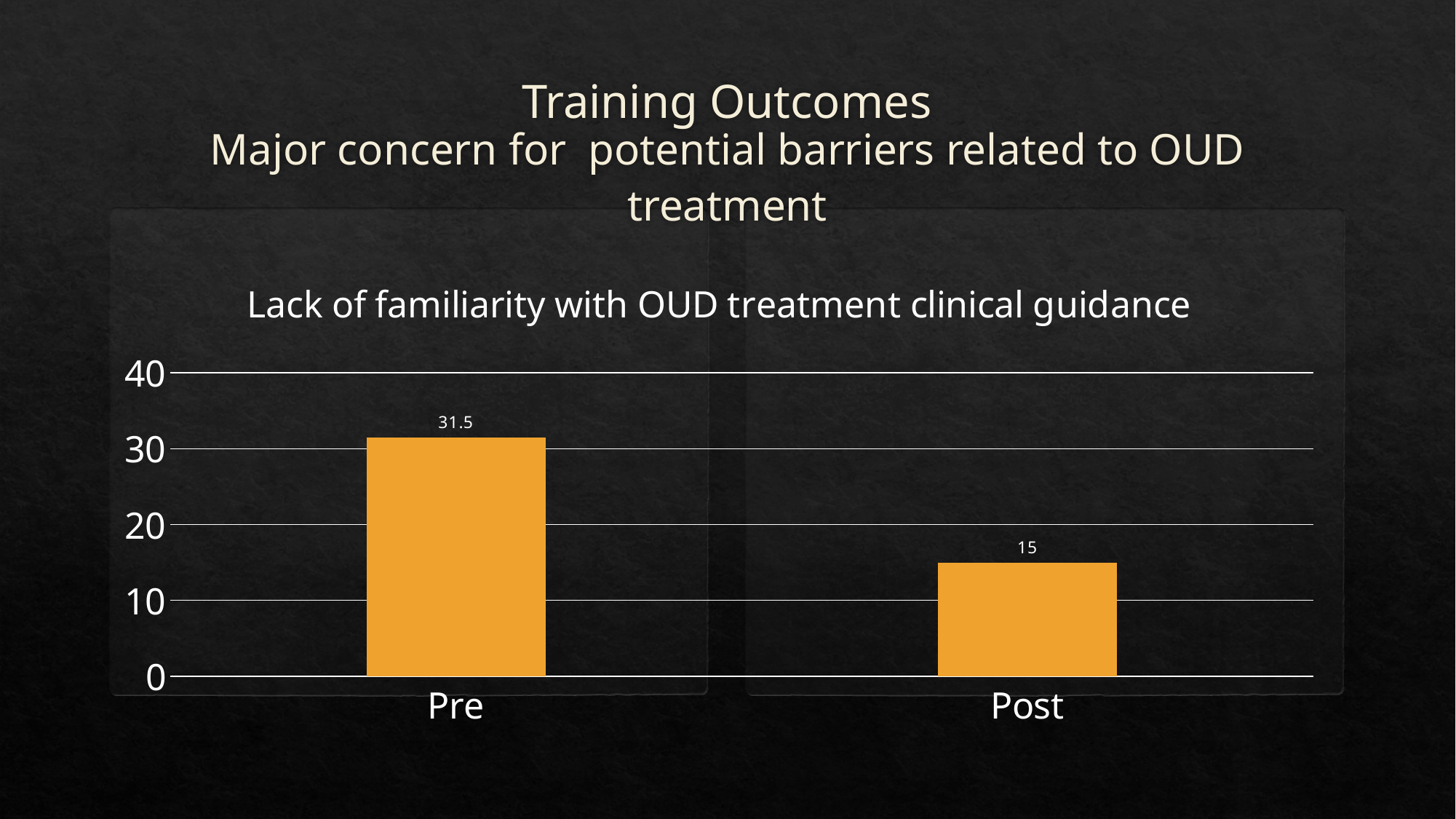
Do the values rise or fall from Pre to Post? fall What kind of chart is shown on the slide? bar chart What is the title of the chart? Lack of familiarity with OUD treatment clinical guidance What is the value for Post? 15 How many categories are shown on the x axis? 2 Which is larger, the value for Pre or the value for Post? Pre Is the value for Post greater or less than 20? less Which category has the highest value? Pre Is the value for Pre greater or less than 30? greater What is the value for Pre? 31.5 Which category has the lowest value? Post What is the difference between the Pre and Post values? 16.5